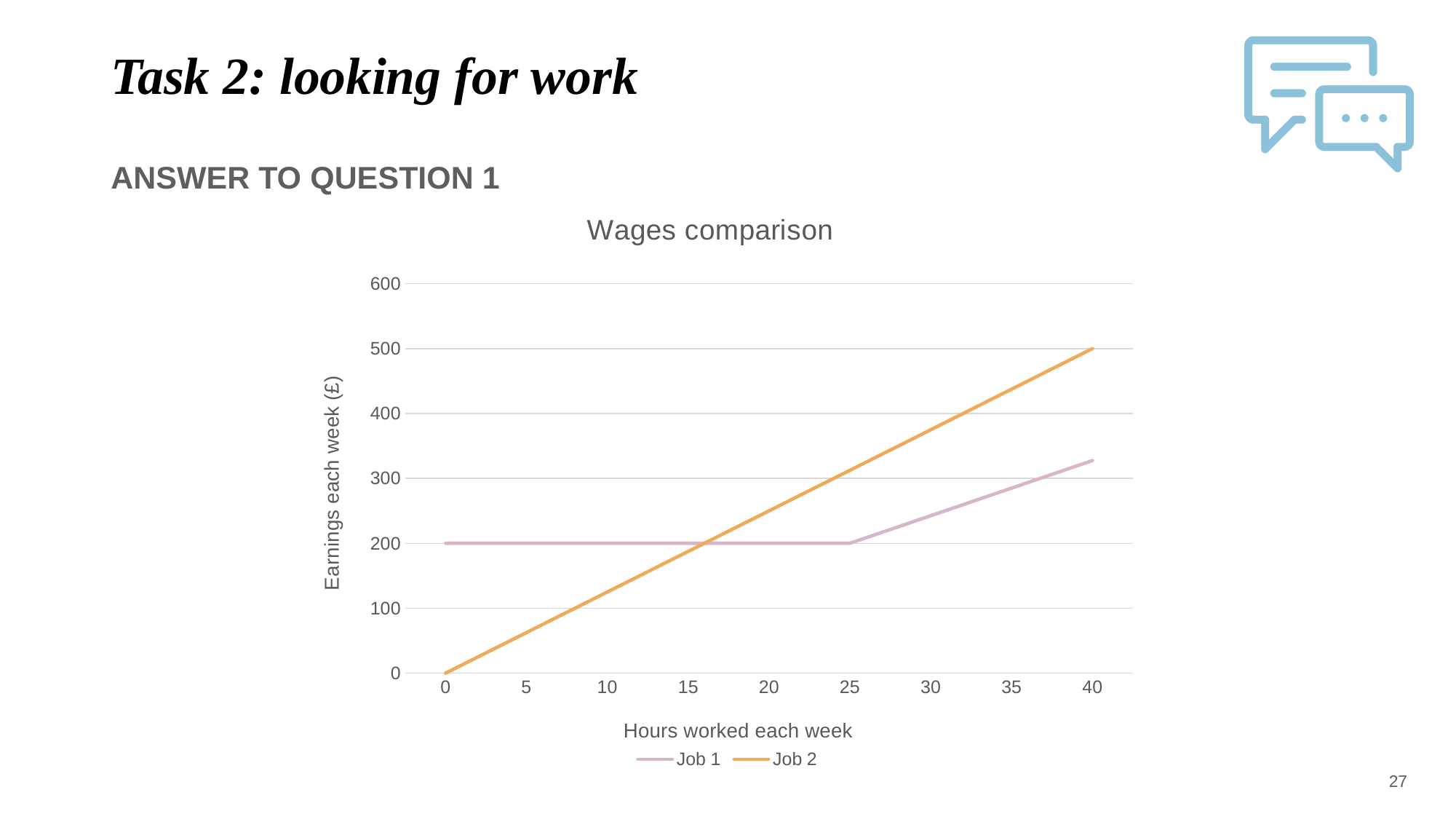
What are the earnings each week for Job 1 at 10 hours worked? 200 What are the earnings each week for Job 2 at 0 hours worked? 0 Is the value for Job 1 at 40 hours worked greater or less than 300? greater At 40 hours worked, which job has the higher earnings each week? Job 2 At 5 hours worked, which job has the higher earnings each week? Job 1 What is the title of the chart? Wages comparison Is the value for Job 2 at 10 hours worked greater or less than 200? less What is the label on the x axis of the chart? Hours worked each week What kind of chart is shown on the slide? Line chart What is the difference between Job 2's earnings at 40 hours and Job 1's earnings at 25 hours? 300 What are the earnings each week for Job 2 at 40 hours worked? 500 How many series does the legend of the Wages comparison chart list? 2